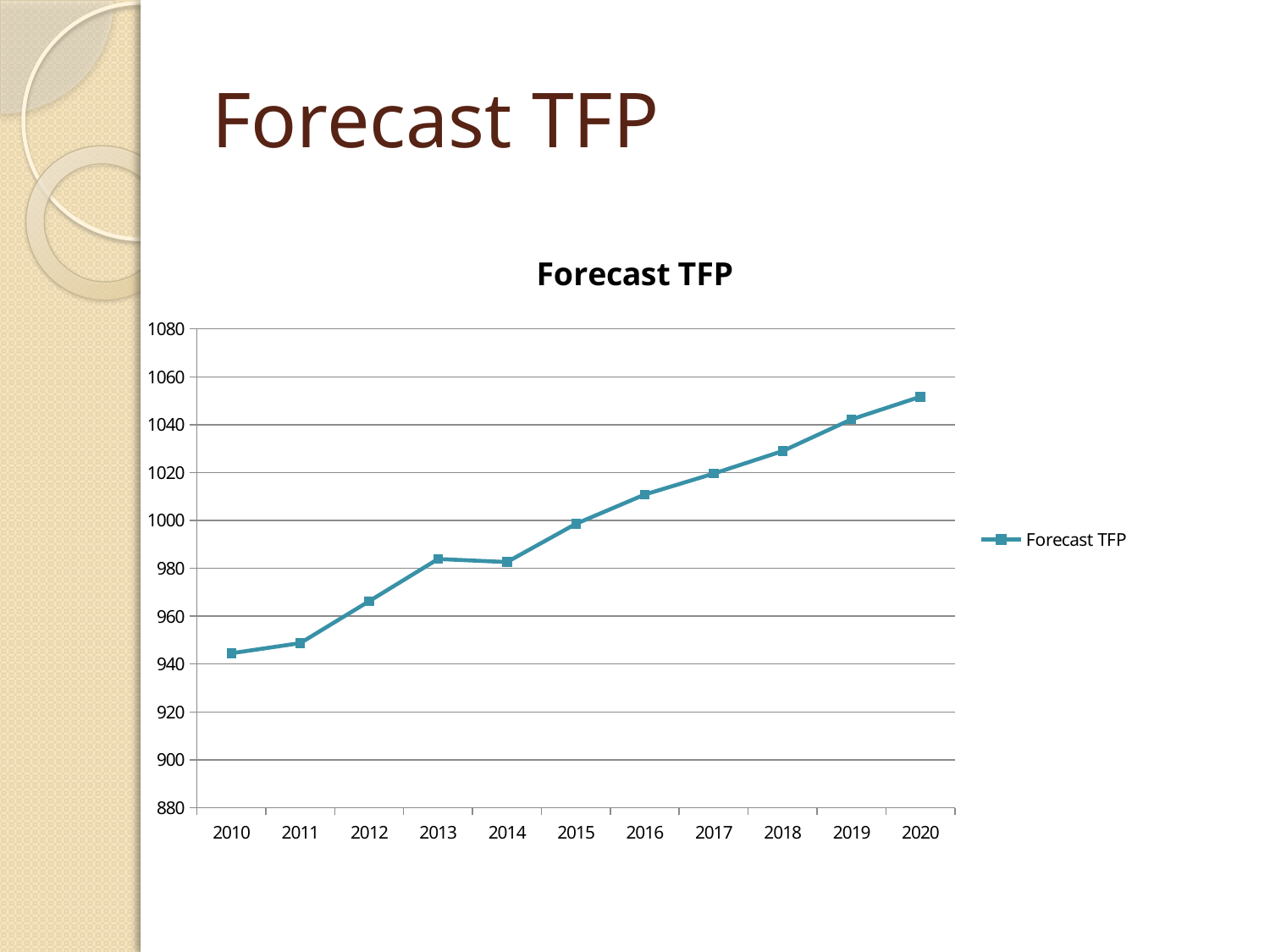
Is the value for 2016 greater or less than 1000? greater Is the value for 2014 greater or less than 1000? less Do the Forecast TFP values generally rise or fall from 2010 to 2020? rise Which year has the larger value, 2015 or 2019? 2019 Is the value for 2020 greater or less than 1040? greater What kind of chart is shown on the slide? line chart How many series does the legend list? 1 Which year has the lowest Forecast TFP value? 2010 Which year has the highest Forecast TFP value? 2020 What is the title of the chart? Forecast TFP How many years are plotted on the x axis? 11